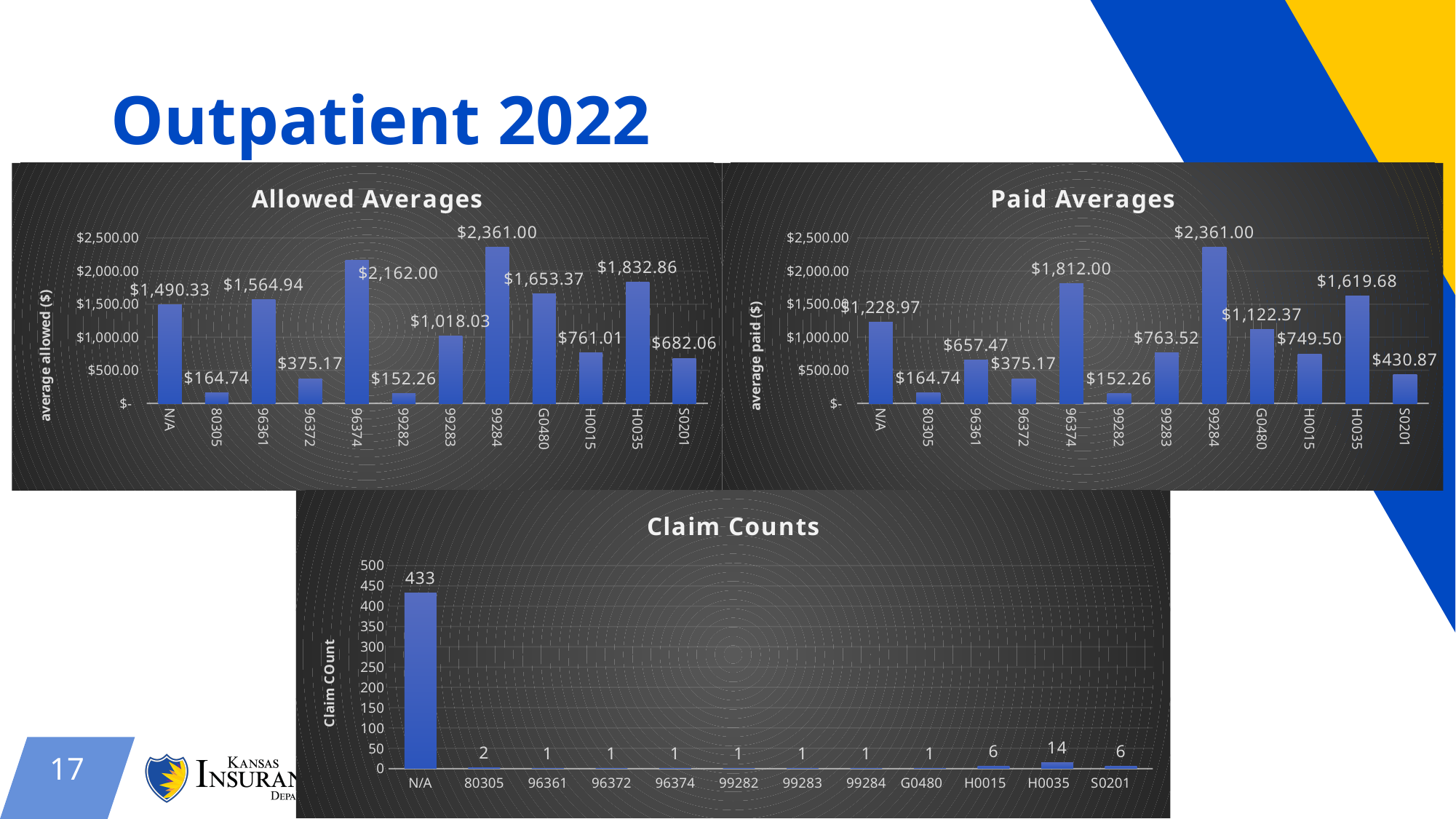
How many categories are shown on the x axis of the Claim Counts chart? 12 In the Claim Counts chart, what is the difference between the claim counts for N/A and H0035? 419 What type of chart is the Paid Averages chart? Bar chart In the Allowed Averages chart, which category has the highest value? 99284 In the Allowed Averages chart, what is the difference between the values for H0035 and H0015? $1,071.85 In the Claim Counts chart, what is the claim count for H0035? 14 In the Paid Averages chart, what is the value for G0480? $1,122.37 In the Paid Averages chart, which is larger, the value for 96361 or the value for 99283? 99283 In the Claim Counts chart, which category has the highest claim count? N/A In the Allowed Averages chart, what is the value for 96374? $2,162.00 In the Paid Averages chart, which category has the lowest value? 99282 What is the y-axis label of the Allowed Averages chart? average allowed ($)